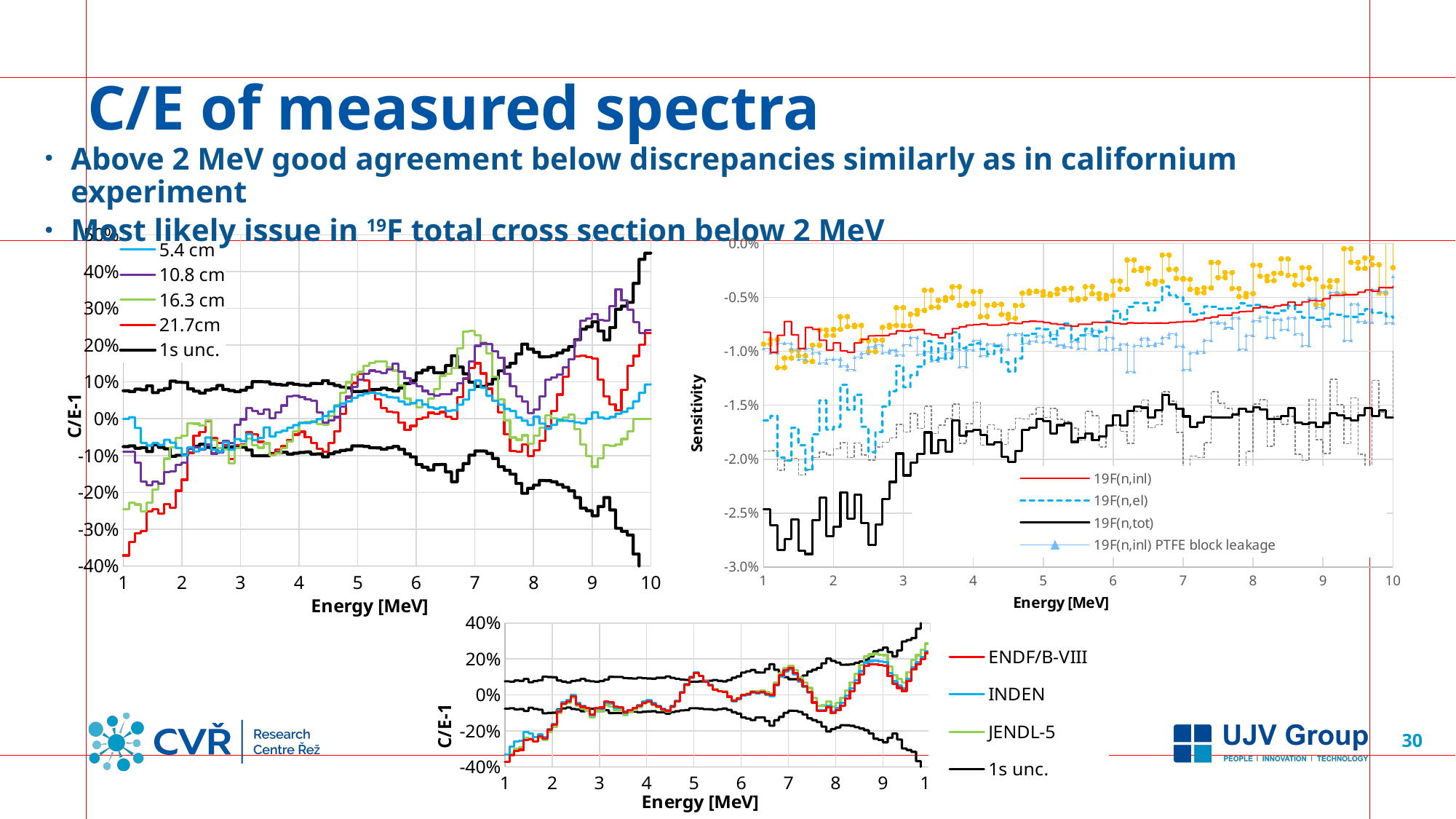
In the top-right chart, is the value of the 19F(n,tot) series at 1 MeV greater or less than -2.0%? less How many series does the legend of the top-left chart list? 5 In the top-right chart, does the 19F(n,tot) series generally rise or fall as energy increases from 1 to 10 MeV? rise In the bottom chart, is the value of the ENDF/B-VIII series at 1 MeV greater or less than -20%? less In the top-left chart, is the value of the 16.3 cm series at 1 MeV greater or less than -20%? less In the top-right chart, does the 19F(n,inl) PTFE block leakage series generally rise or fall as energy increases? rise How many series does the legend of the bottom chart list? 4 How many series does the legend of the top-right chart (Sensitivity) list? 4 What type of chart is the top-left chart on the slide? line chart What is the y-axis label of the top-right chart? Sensitivity What is the x-axis label of the bottom chart? Energy [MeV]